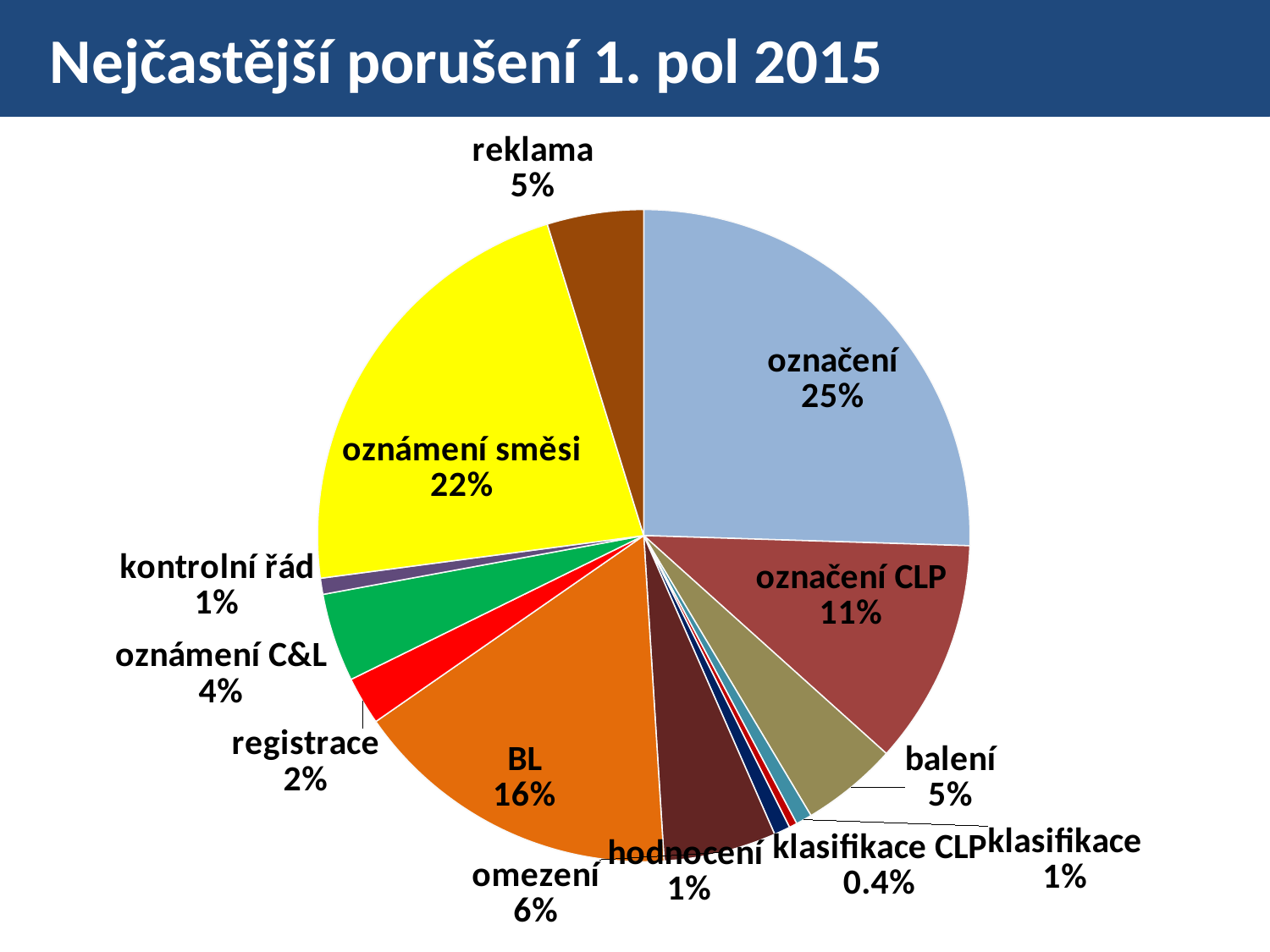
What is the share for označení CLP? 11% What kind of chart is shown on the slide? pie chart How many categories are shown in the pie chart? 13 What is the share for BL? 16% Which category has the largest slice of the pie? označení What is the title of the slide? Nejčastější porušení 1. pol 2015 What is the share for klasifikace CLP? 0.4% What is the share for označení? 25% Which is larger, the share for BL or the share for označení CLP? BL Which category has the smallest slice of the pie? klasifikace CLP What is the difference in percentage points between označení and oznámení směsi? 3% What is the share for oznámení směsi? 22%